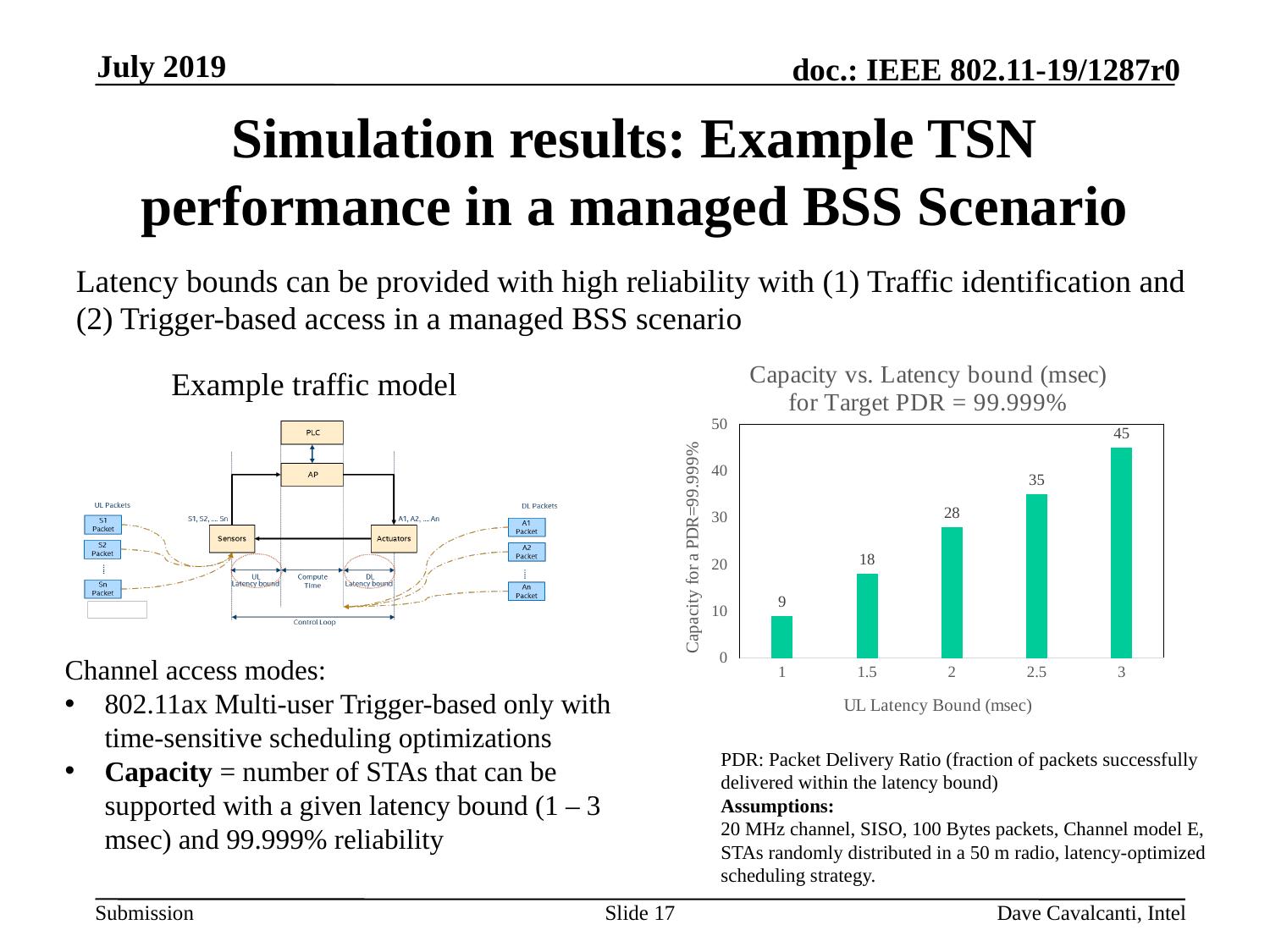
What is the capacity at a UL latency bound of 2 msec? 28 Which UL latency bound has the lowest capacity? 1 What is the capacity at a UL latency bound of 1 msec? 9 Which has a larger capacity: a latency bound of 1.5 msec or 2 msec? 2 How many latency bound values are plotted in the chart? 5 Is the capacity at a latency bound of 2.5 msec greater or less than 30? greater What is the capacity at a UL latency bound of 3 msec? 45 Which UL latency bound has the highest capacity? 3 What kind of chart is used to show capacity vs. latency bound? bar chart Does capacity rise or fall as the UL latency bound increases? rise What is the difference in capacity between a latency bound of 2.5 msec and 1.5 msec? 17 What is the title of the chart? Capacity vs. Latency bound (msec) for Target PDR = 99.999%